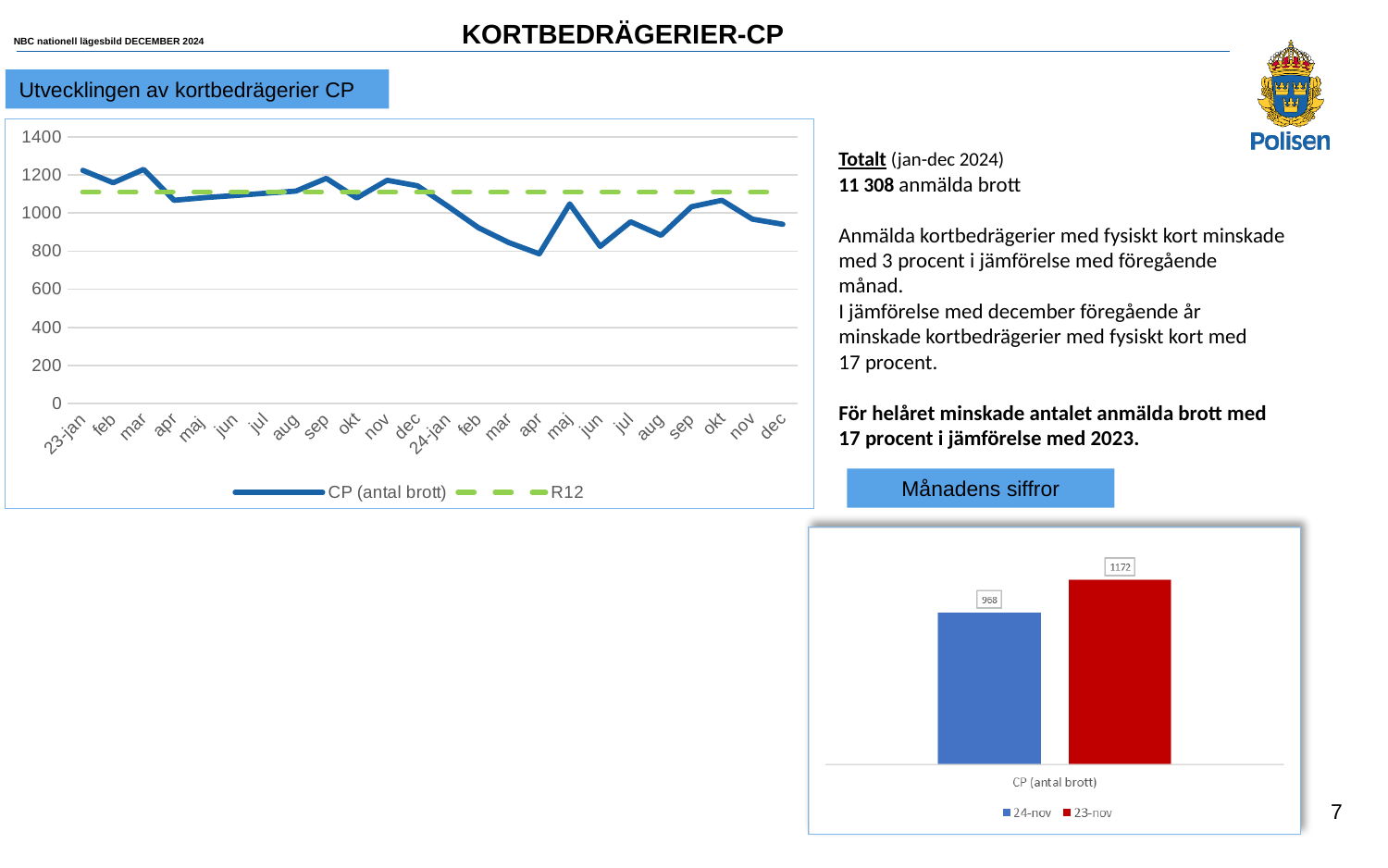
In the chart titled 'Utvecklingen av kortbedrägerier CP', how many series does the legend list? 2 In the bar chart titled 'Månadens siffror', what is the difference between the 23-nov and 24-nov values? 204 In the chart titled 'Utvecklingen av kortbedrägerier CP', is the CP (antal brott) value for 23-jan greater or less than 1000? greater In the chart titled 'Utvecklingen av kortbedrägerier CP', what are the two legend entries? CP (antal brott) and R12 In the chart titled 'Utvecklingen av kortbedrägerier CP', is the CP (antal brott) value for feb 2024 (after 24-jan) greater or less than 1000? less In the bar chart titled 'Månadens siffror', what is the value for 24-nov? 968 What kind of chart is the 'Utvecklingen av kortbedrägerier CP' chart? line chart In the bar chart titled 'Månadens siffror', what is the value for 23-nov? 1172 In the chart titled 'Utvecklingen av kortbedrägerier CP', does the CP (antal brott) line overall rise or fall from 23-jan to the final dec? fall What kind of chart is the 'Månadens siffror' chart? bar chart In the bar chart titled 'Månadens siffror', how many series does the legend list? 2 In the bar chart titled 'Månadens siffror', which is larger, 24-nov or 23-nov? 23-nov